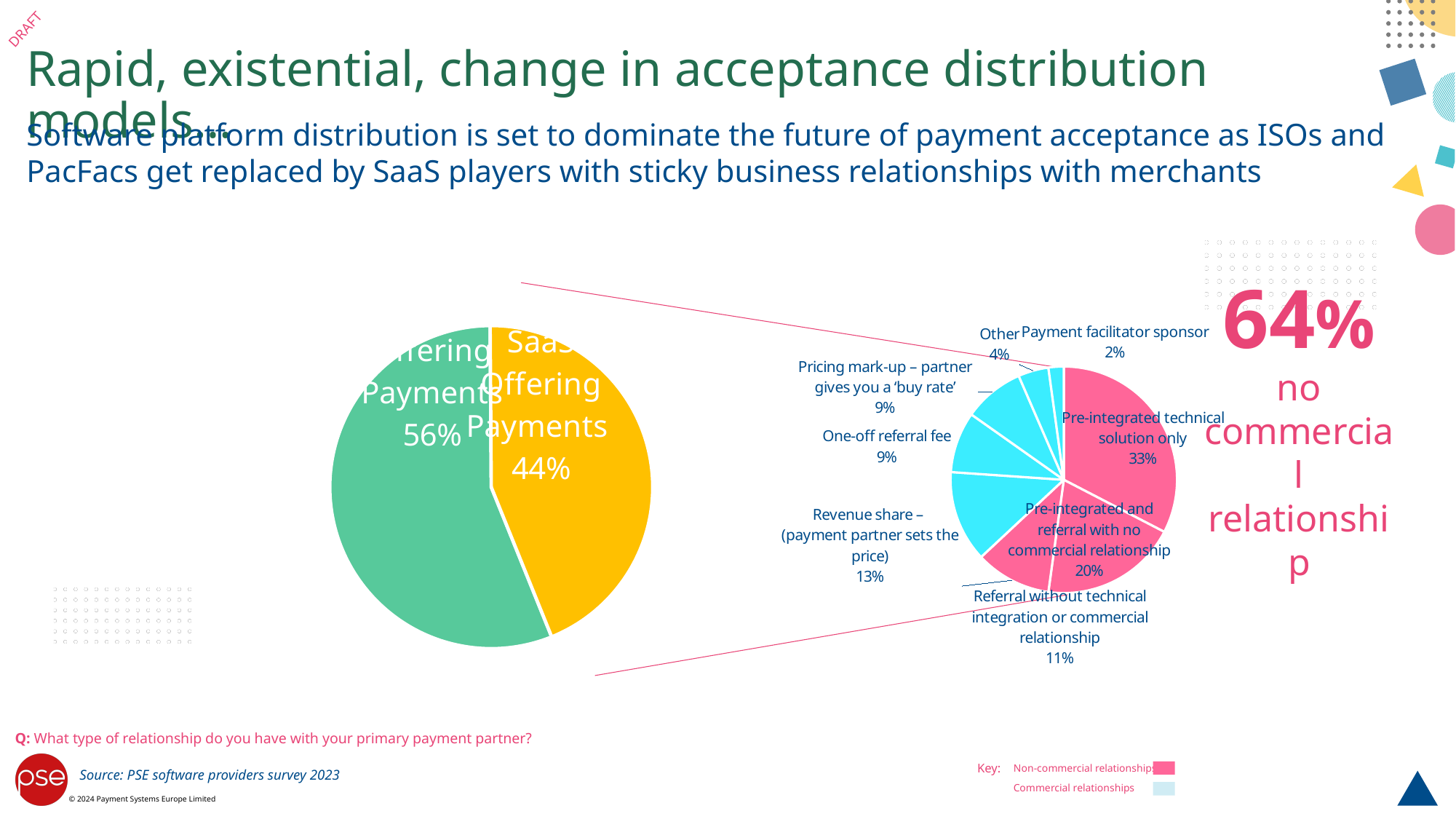
In the right pie chart, which category has the largest share? Pre-integrated technical solution only In the right pie chart, what share is 'Pre-integrated and referral with no commercial relationship'? 20% In the right pie chart, what share is 'Revenue share – (payment partner sets the price)'? 13% How many slices does the right pie chart have? 8 In the right pie chart, what share is 'Pre-integrated technical solution only'? 33% In the right pie chart, which category has the smallest share? Payment facilitator sponsor In the right pie chart, which is larger: 'One-off referral fee' or 'Other'? One-off referral fee According to the key, what colour represents non-commercial relationships in the right pie chart? Pink In the left pie chart, what share is labelled 'SaaS Offering Payments'? 44% In the right pie chart, what is the difference between 'Pre-integrated technical solution only' and 'Referral without technical integration or commercial relationship'? 22% In the left pie chart, what percentage is shown on the green slice? 56% What kind of chart is the left chart on the slide? Pie chart